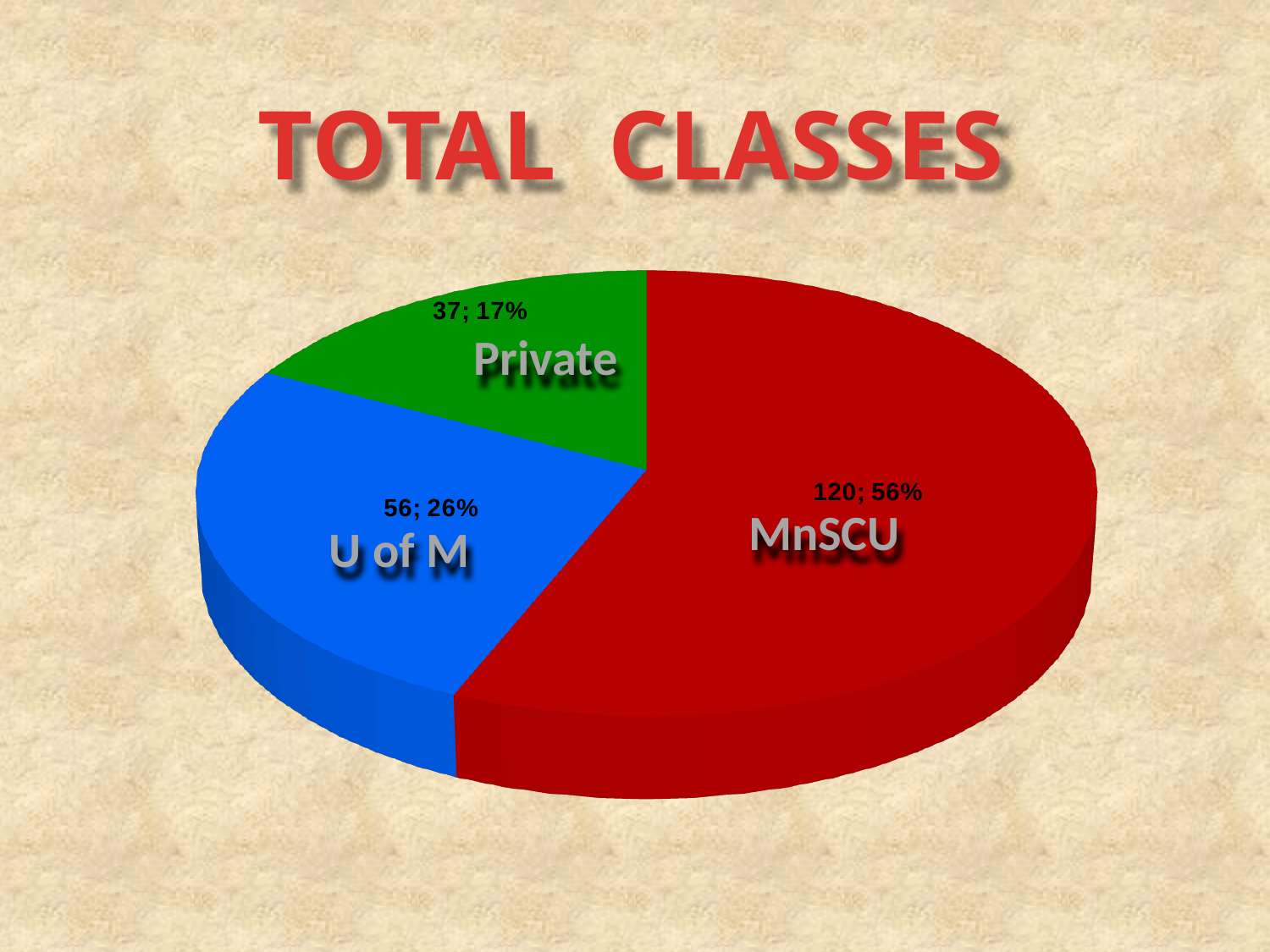
How many classes does the MnSCU slice represent? 120 How many slices does the pie chart have? 3 Which category has the largest slice? MnSCU Which colour is the U of M slice? blue What is the title of the chart? TOTAL CLASSES What percentage share of the pie is the MnSCU slice? 56% What kind of chart is shown on the slide? pie chart How many classes does the Private slice represent? 37 What is the difference in number of classes between MnSCU and U of M? 64 How many classes does the U of M slice represent? 56 Which category has the smallest slice? Private What percentage share of the pie is the Private slice? 17%